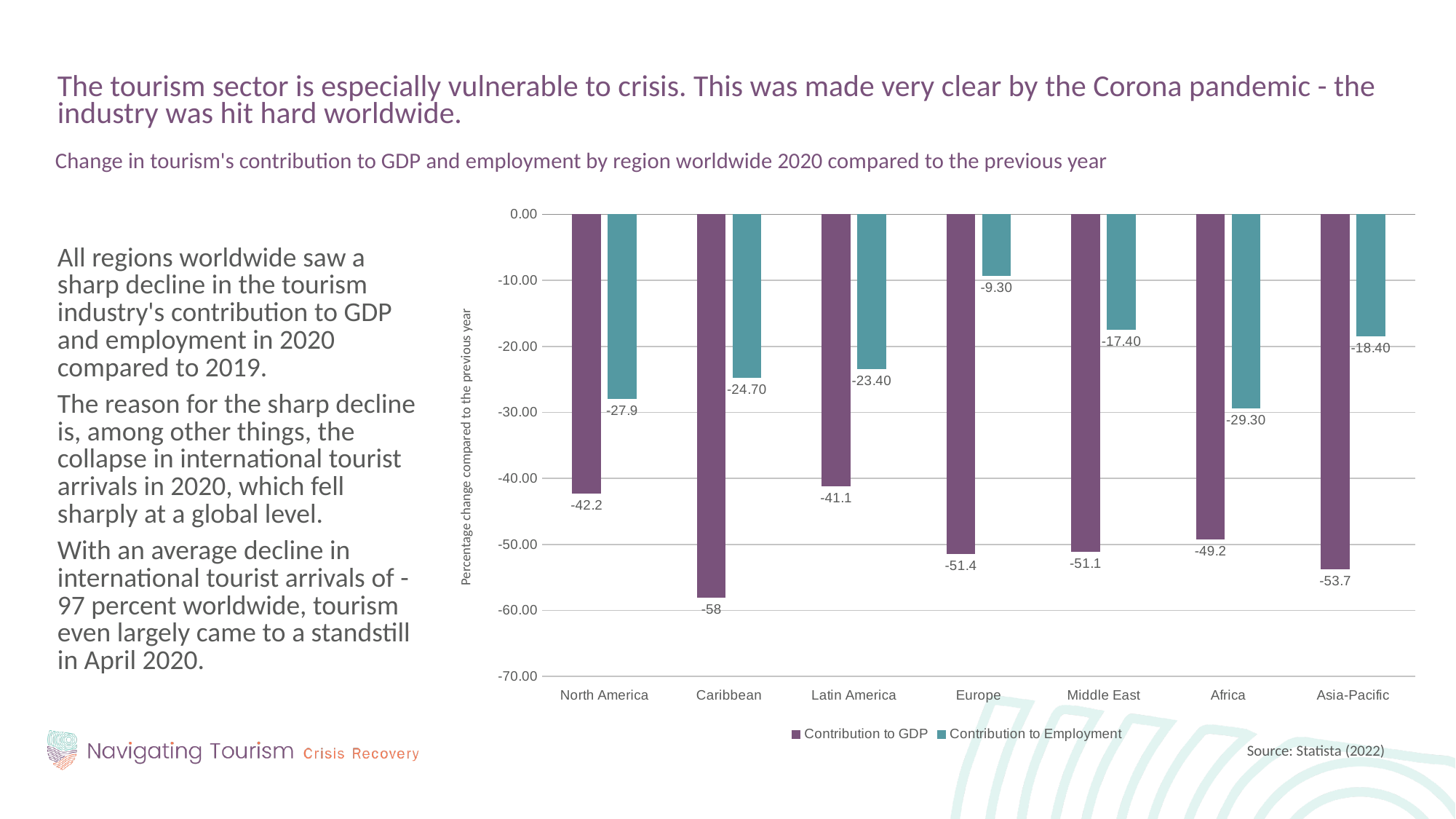
What is the Contribution to Employment value for Europe? -9.30 Which region has the lowest (most negative) Contribution to Employment value? Africa Which region has the highest (least negative) Contribution to Employment value? Europe What is the Contribution to Employment value for Africa? -29.30 How many series does the chart's legend list? 2 Which is more negative for the Middle East: Contribution to GDP or Contribution to Employment? Contribution to GDP What is the Contribution to GDP value for Asia-Pacific? -53.7 How many regions are shown on the x axis of the chart? 7 What is the difference between the Contribution to GDP and Contribution to Employment values for Europe? 42.1 What kind of chart is shown on the slide? Bar chart Which region has the lowest (most negative) Contribution to GDP value? Caribbean What is the Contribution to GDP value for the Caribbean? -58